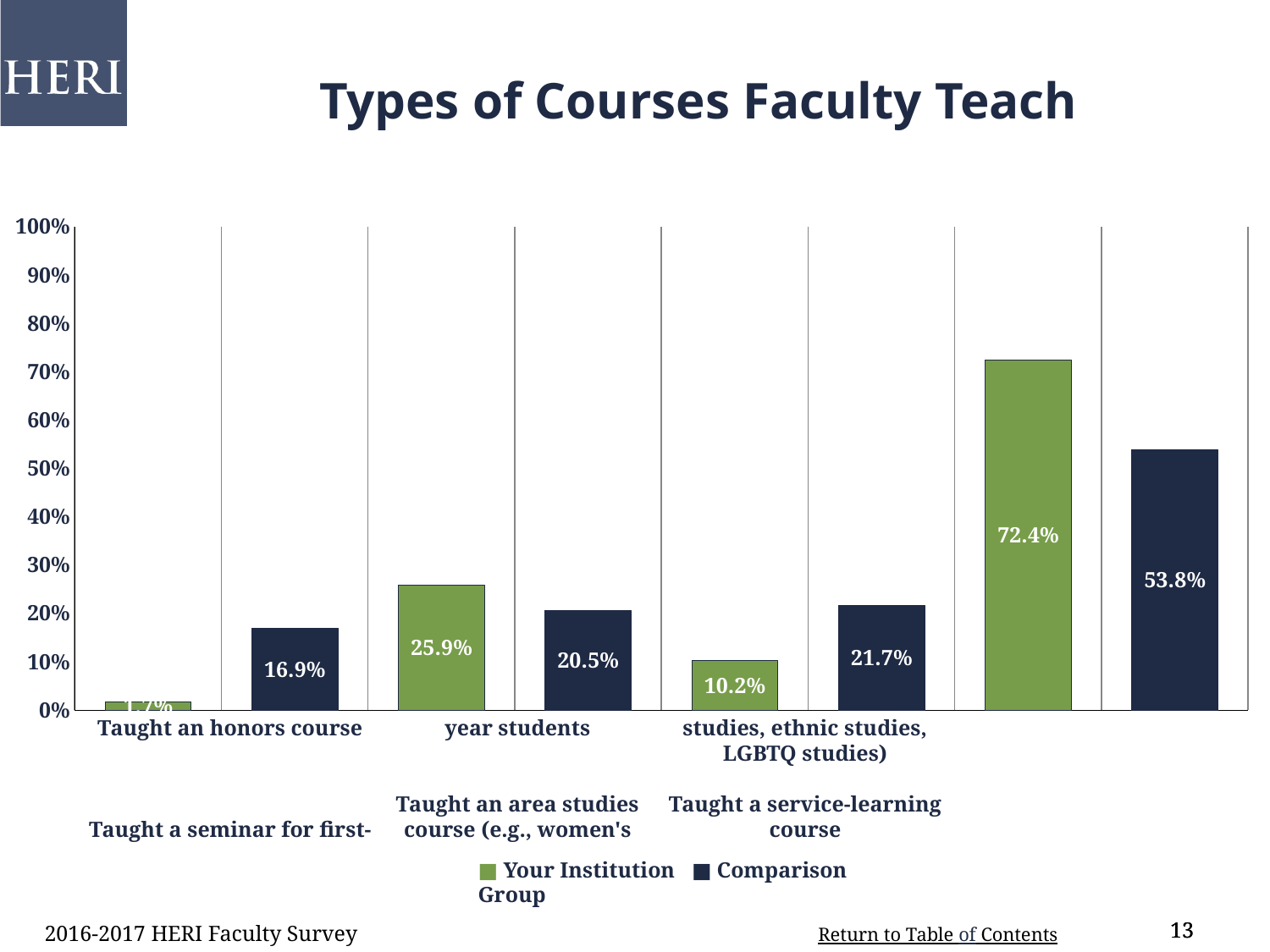
How many course types are shown on the x axis? 4 What type of chart is shown on the slide? bar chart For 'Taught an area studies course', which is larger: Your Institution or Comparison Group? Comparison Group How many series does the legend list? 2 Is the Your Institution value for 'Taught an honors course' greater or less than 10%? less What is the Your Institution value for 'Taught a seminar for first-year students'? 25.9% What is the Comparison Group value for 'Taught an area studies course'? 21.7% Which course type has the highest Your Institution value? Taught a service-learning course What is the difference between the Your Institution and Comparison Group values for 'Taught a service-learning course'? 18.6% What is the Comparison Group value for 'Taught a service-learning course'? 53.8% What is the Your Institution value for 'Taught a service-learning course'? 72.4% What is the Comparison Group value for 'Taught an honors course'? 16.9%